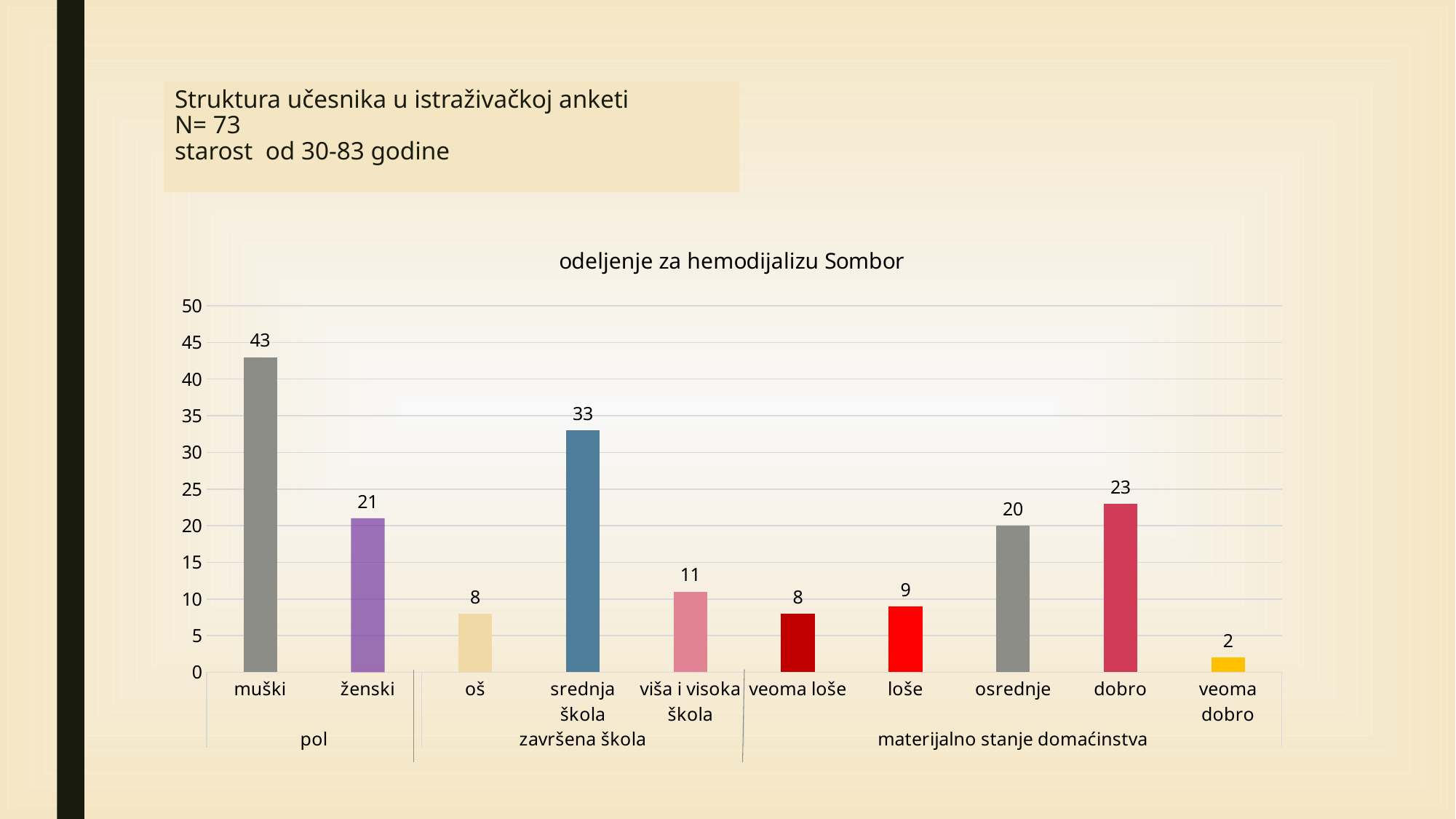
Which category has the highest value? muški Which category has the lowest value? veoma dobro Which is larger, the value for dobro or the value for osrednje? dobro What is the value for osrednje? 20 What is the value for srednja škola? 33 What is the difference between the values for srednja škola and viša i visoka škola? 22 What is the title of the chart? odeljenje za hemodijalizu Sombor What is the difference between the values for muški and ženski? 22 How many bars are plotted in the chart? 10 What is the value for muški? 43 What kind of chart is shown? bar chart What is the value for veoma dobro? 2